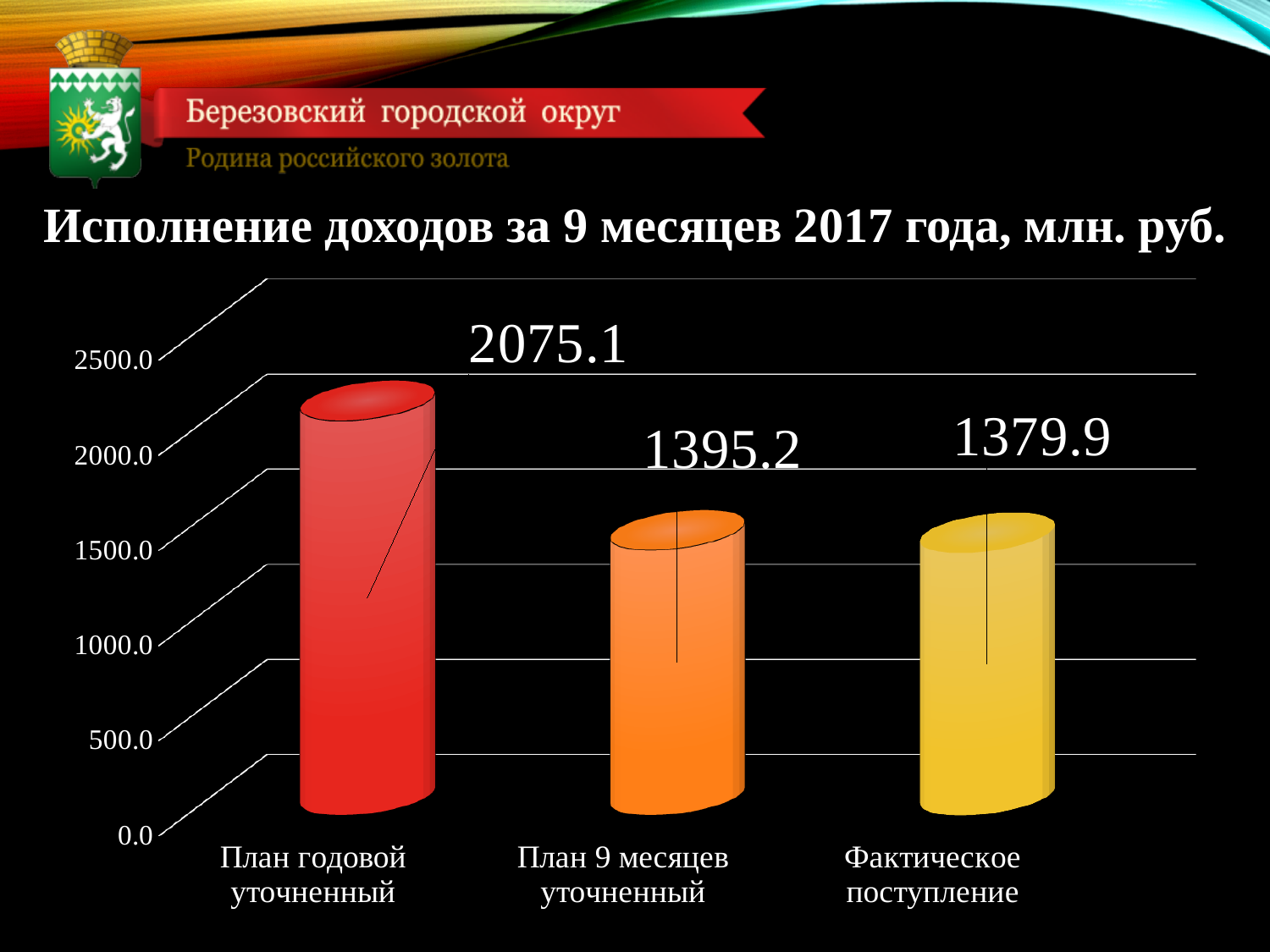
What kind of chart is shown on the slide? Bar chart Which category has the lowest value? Фактическое поступление How many categories are shown in the chart? 3 What is the title of the chart? Исполнение доходов за 9 месяцев 2017 года, млн. руб. Which category has the highest value? План годовой уточненный What is the value for «Фактическое поступление»? 1379.9 What is the value for «План 9 месяцев уточненный»? 1395.2 What is the difference between «План годовой уточненный» and «План 9 месяцев уточненный»? 679.9 Which is larger, «План 9 месяцев уточненный» or «Фактическое поступление»? План 9 месяцев уточненный What is the difference between «План 9 месяцев уточненный» and «Фактическое поступление»? 15.3 Is the value for «План годовой уточненный» greater or less than 2000.0? greater What is the value for «План годовой уточненный»? 2075.1